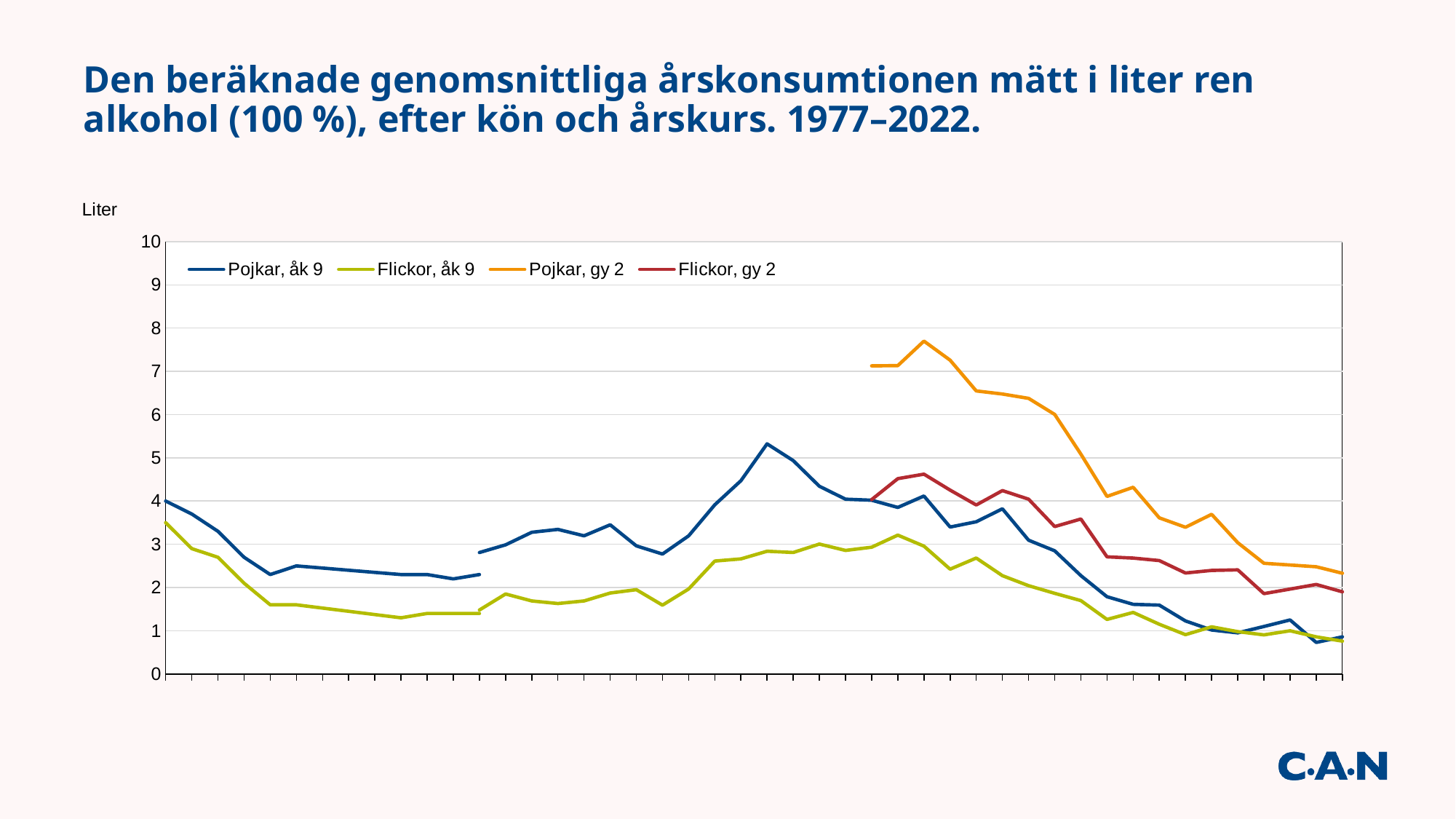
Which series reaches the highest value anywhere on the chart? Pojkar, gy 2 At their respective peaks, which series is higher: Pojkar, gy 2 or Flickor, gy 2? Pojkar, gy 2 What unit label is shown above the y axis? Liter Does the Pojkar, gy 2 series rise or fall overall from its first point to its last point? fall Of the two series that start at the left edge of the chart, which has the lower starting value? Flickor, åk 9 What are the four series named in the legend? Pojkar, åk 9; Flickor, åk 9; Pojkar, gy 2; Flickor, gy 2 What kind of chart is shown on the slide? line chart Is the highest value of the Flickor, åk 9 series greater or less than 4? less Is the peak value of the Pojkar, åk 9 series greater or less than 5? greater How many series does the legend list? 4 Is the first value of the Pojkar, åk 9 series greater or less than 3? greater